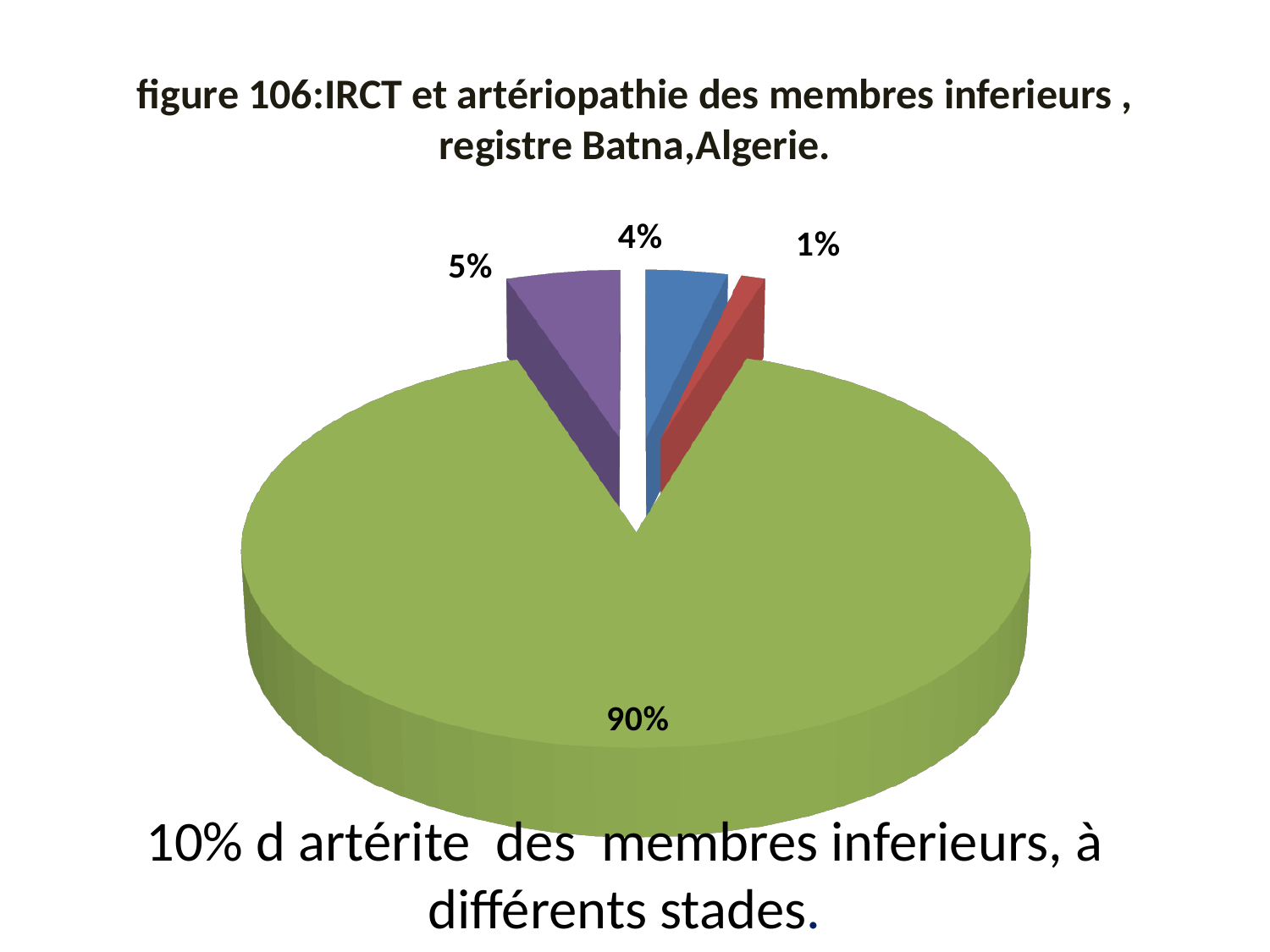
Which slice is larger, the purple slice or the blue slice? the purple slice What is the value of the smallest slice of the pie chart? 1% What value is labelled on the blue slice? 4% What is the value of the largest slice of the pie chart? 90% What is the title of the chart? figure 106:IRCT et artériopathie des membres inferieurs , registre Batna,Algerie. What share of the pie does the green slice represent? 90% What value is labelled on the red slice? 1% What do the three small slices (purple, blue and red) add up to? 10% What is the difference in percentage points between the green slice and the purple slice? 85 What value is labelled on the purple slice? 5% How many slices does the pie chart have? 4 What kind of chart is shown on the slide? pie chart